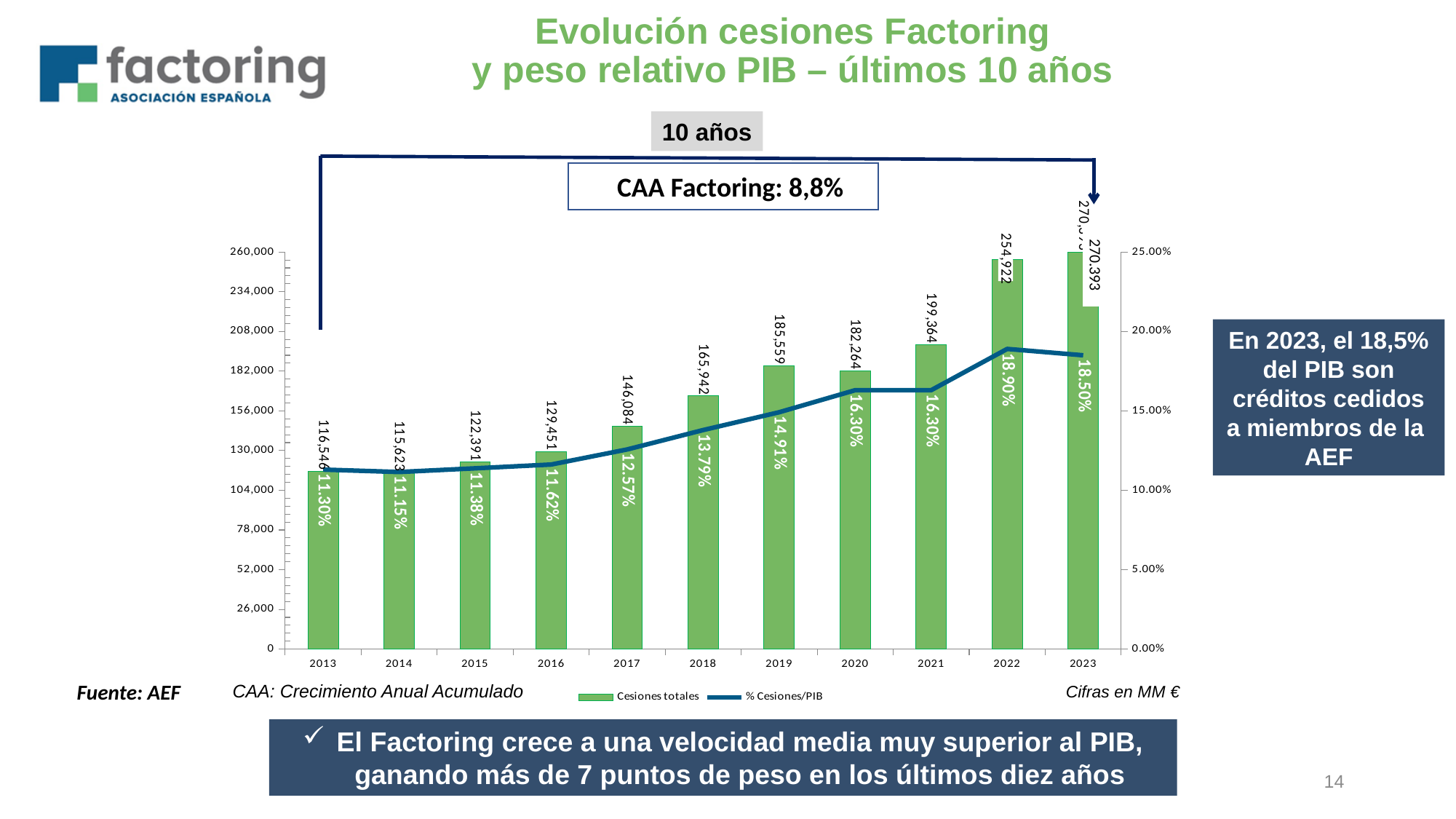
Is the Cesiones totales value for 2018 greater or less than 156,000? greater What is the difference in Cesiones totales between 2022 and 2021? 55,558 Which year has the highest Cesiones totales? 2023 What is the % Cesiones/PIB value for 2019? 14.91% How many series does the chart legend list? 2 Which year has a higher % Cesiones/PIB, 2022 or 2023? 2022 What is the value of Cesiones totales for 2017? 146,084 What kind of chart is used to show Cesiones totales? Bar chart What is the CAA Factoring figure shown in the box above the chart? 8,8% Does the % Cesiones/PIB line generally rise or fall from 2014 to 2022? Rise Which year has the lowest Cesiones totales? 2014 How many years are shown on the x axis of the chart? 11